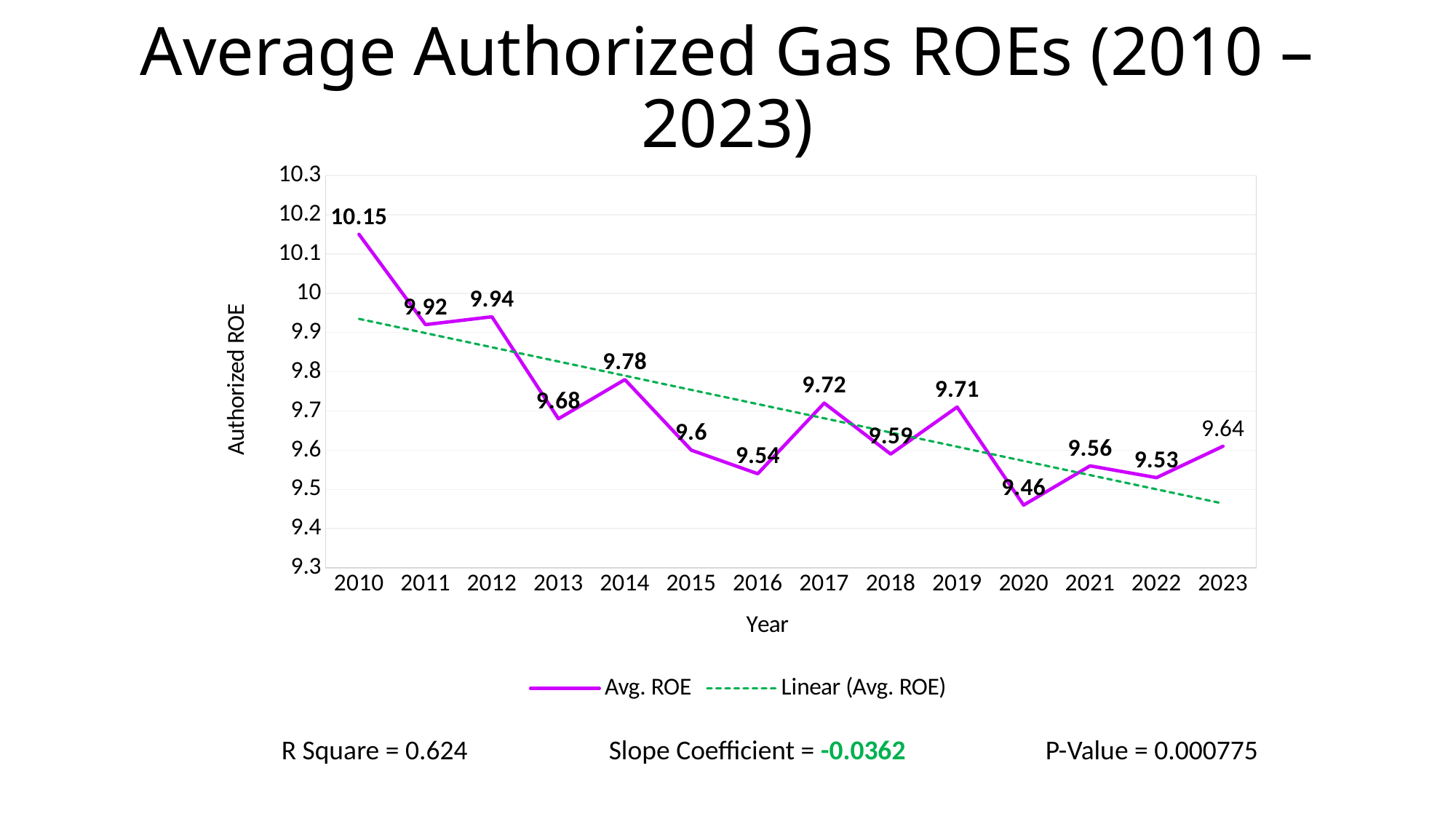
How many series does the legend list? 2 What is the difference between the Avg. ROE in 2010 and in 2023? 0.51 What is the Avg. ROE value for 2020? 9.46 Does the Avg. ROE generally rise or fall from 2010 to 2023? fall What kind of chart is shown on the slide? line chart How many years are plotted on the x axis? 14 Is the Avg. ROE value for 2012 greater or less than 9.9? greater Which year has the lowest Avg. ROE? 2020 Which year has the highest Avg. ROE? 2010 What is the Avg. ROE value for 2010? 10.15 Which year has a higher Avg. ROE, 2014 or 2017? 2014 What is the Avg. ROE value for 2023? 9.64